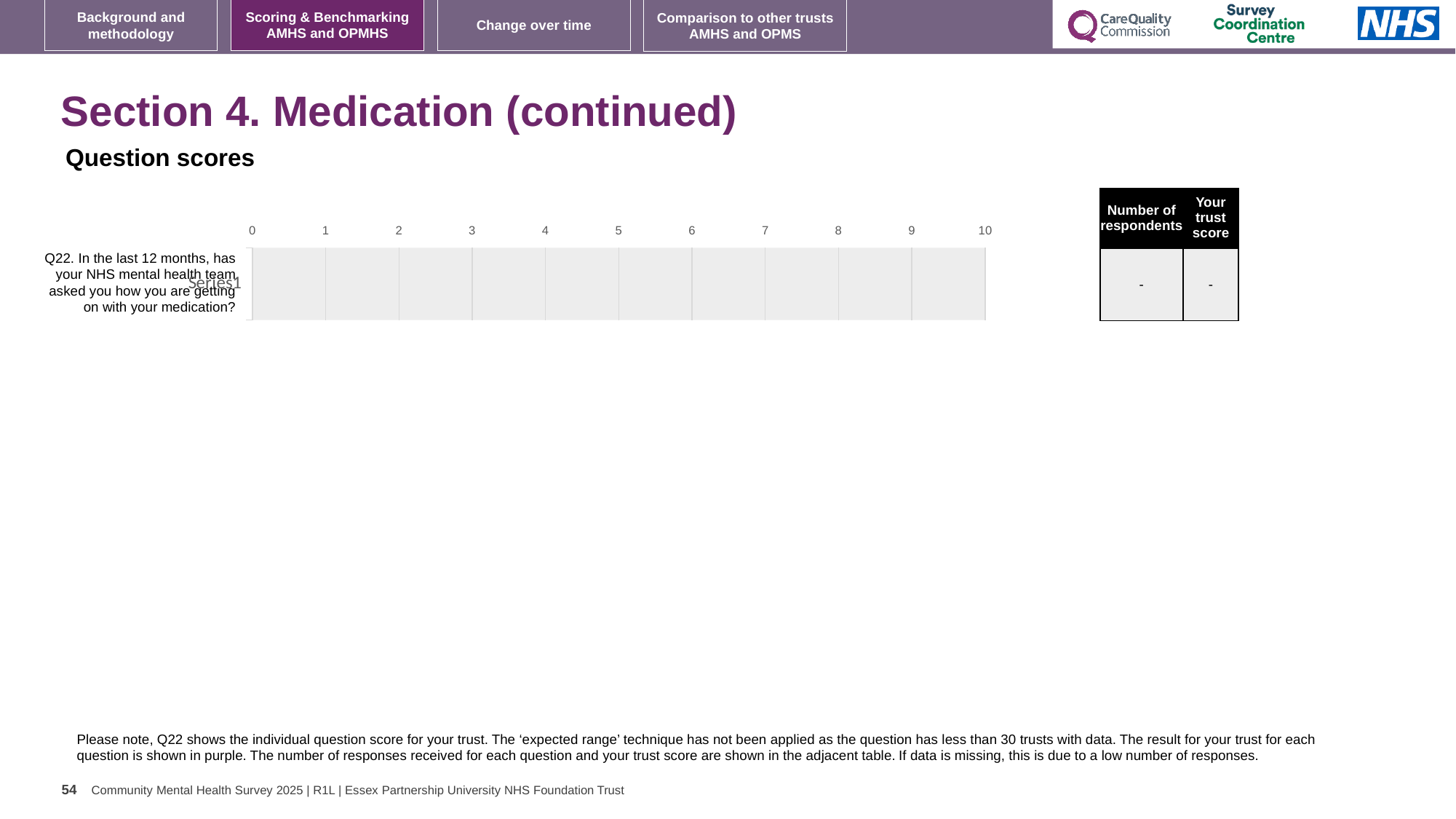
What value is shown for 'Your trust score' in the table next to the chart? - Which question is labelled on the chart's vertical axis? Q22. In the last 12 months, has your NHS mental health team asked you how you are getting on with your medication? What kind of chart is shown on the slide? bar chart What is the highest value shown on the chart's horizontal axis? 10 What value is shown for 'Number of respondents' in the table next to the chart? - How many question categories are listed on the chart's vertical axis? 1 Is any bar plotted for Q22 on the chart? No